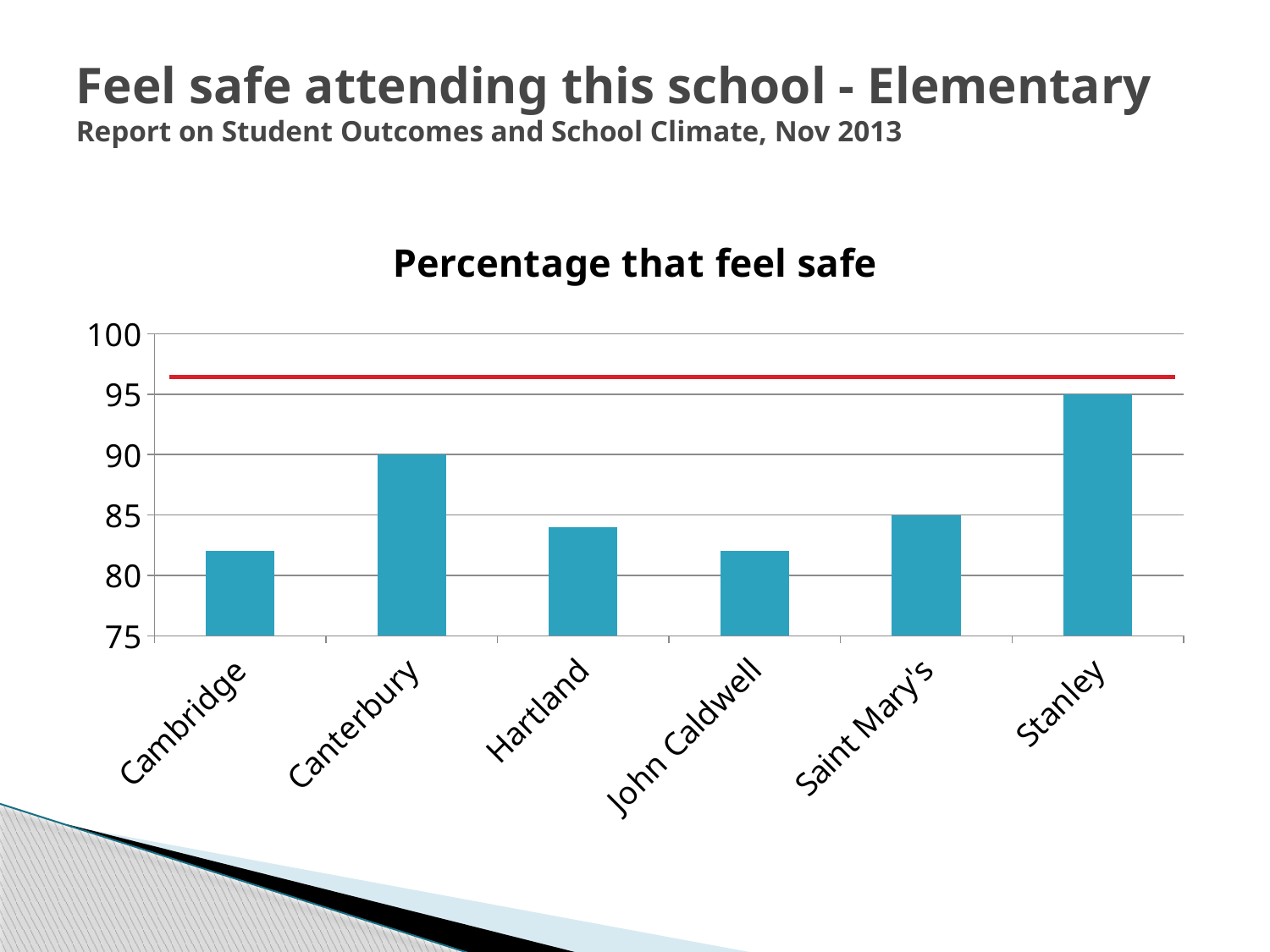
Is the value for Hartland greater or less than 85? less What is the percentage that feel safe for Stanley? 95 Which school has the highest percentage that feel safe? Stanley What is the title of the chart? Percentage that feel safe What is the difference between the values for Stanley and Canterbury? 5 Is the value for Cambridge greater or less than 85? less What type of chart is shown on the slide? bar chart What colour are the bars in the chart? blue Which has a higher percentage that feel safe, Canterbury or Hartland? Canterbury How many schools are shown on the x axis of the chart? 6 What is the percentage that feel safe for Saint Mary's? 85 What is the percentage that feel safe for Canterbury? 90